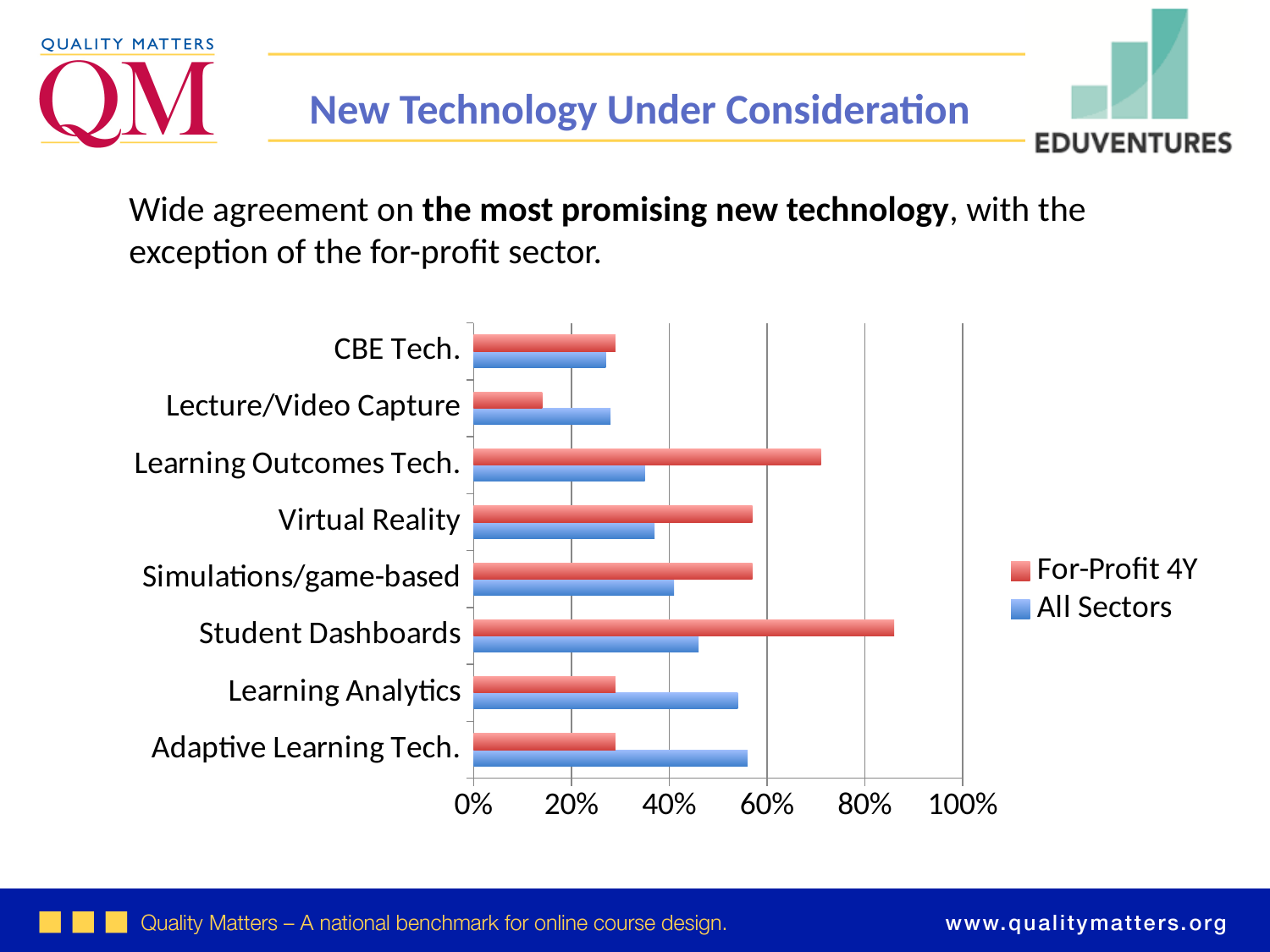
What kind of chart is shown on the slide? Bar chart For Learning Analytics, which series has the larger value, For-Profit 4Y or All Sectors? All Sectors How many technology categories are plotted on the chart? 8 For Student Dashboards, which series has the larger value, For-Profit 4Y or All Sectors? For-Profit 4Y Which category has the highest For-Profit 4Y value? Student Dashboards Is the For-Profit 4Y value for Student Dashboards greater or less than 80%? greater Is the For-Profit 4Y value for Lecture/Video Capture greater or less than 20%? less Is the For-Profit 4Y value for Learning Outcomes Tech. greater or less than 60%? greater How many series does the chart legend list? 2 Which category has the lowest For-Profit 4Y value? Lecture/Video Capture Which colour represents the For-Profit 4Y series in the chart? Red